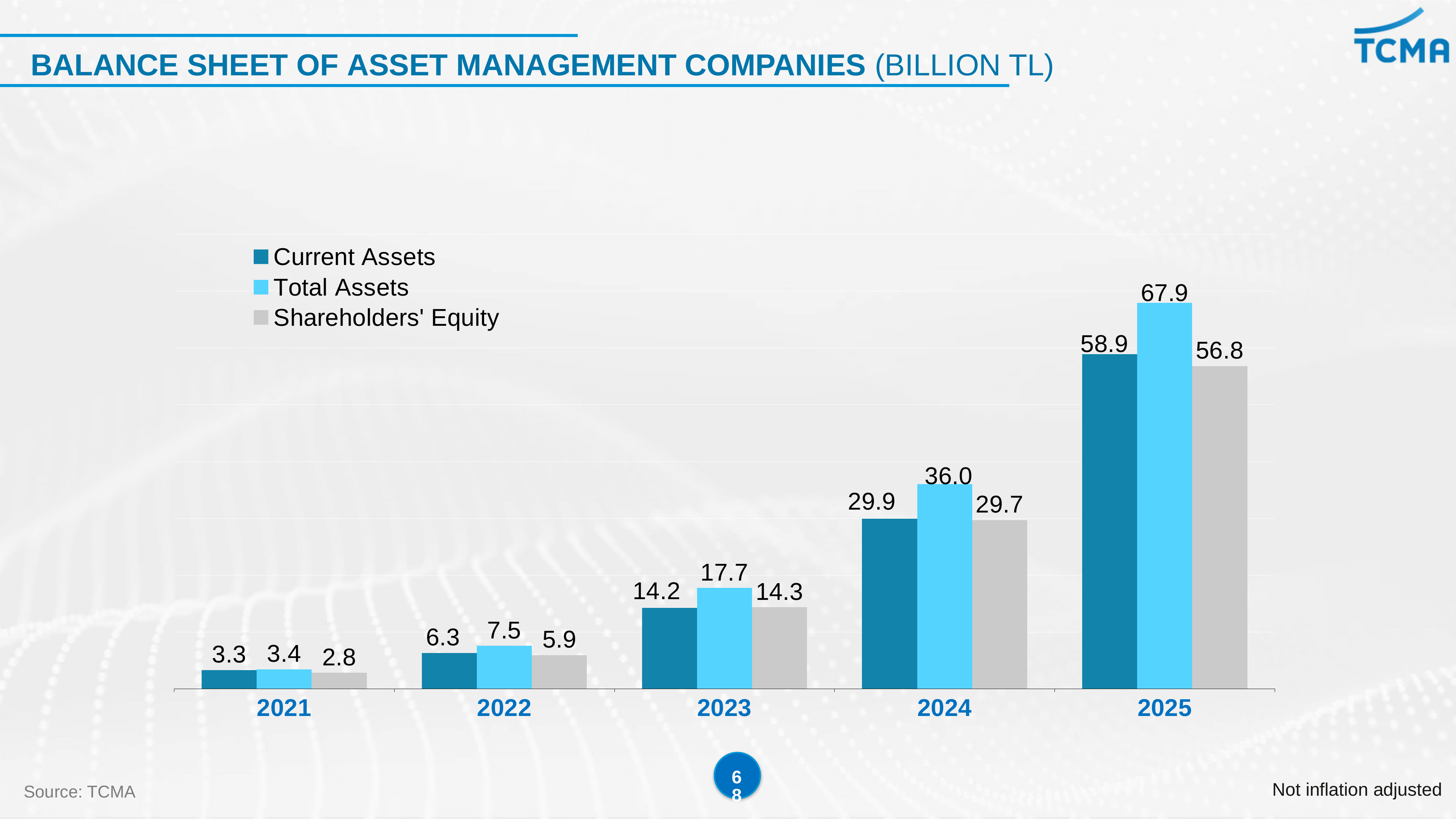
What is the value of Shareholders' Equity in 2021? 2.8 How many series does the legend list? 3 In which year is Shareholders' Equity lowest? 2021 Do the Total Assets values rise or fall from 2021 to 2025? Rise What is the difference between Total Assets and Current Assets in 2024? 6.1 In which year is Total Assets highest? 2025 What is the value of Total Assets in 2025? 67.9 What unit is given in the chart title? Billion TL How many years are shown on the x axis? 5 What kind of chart is shown on the slide? Bar chart Which is larger in 2022: Current Assets or Shareholders' Equity? Current Assets What is the value of Current Assets in 2023? 14.2